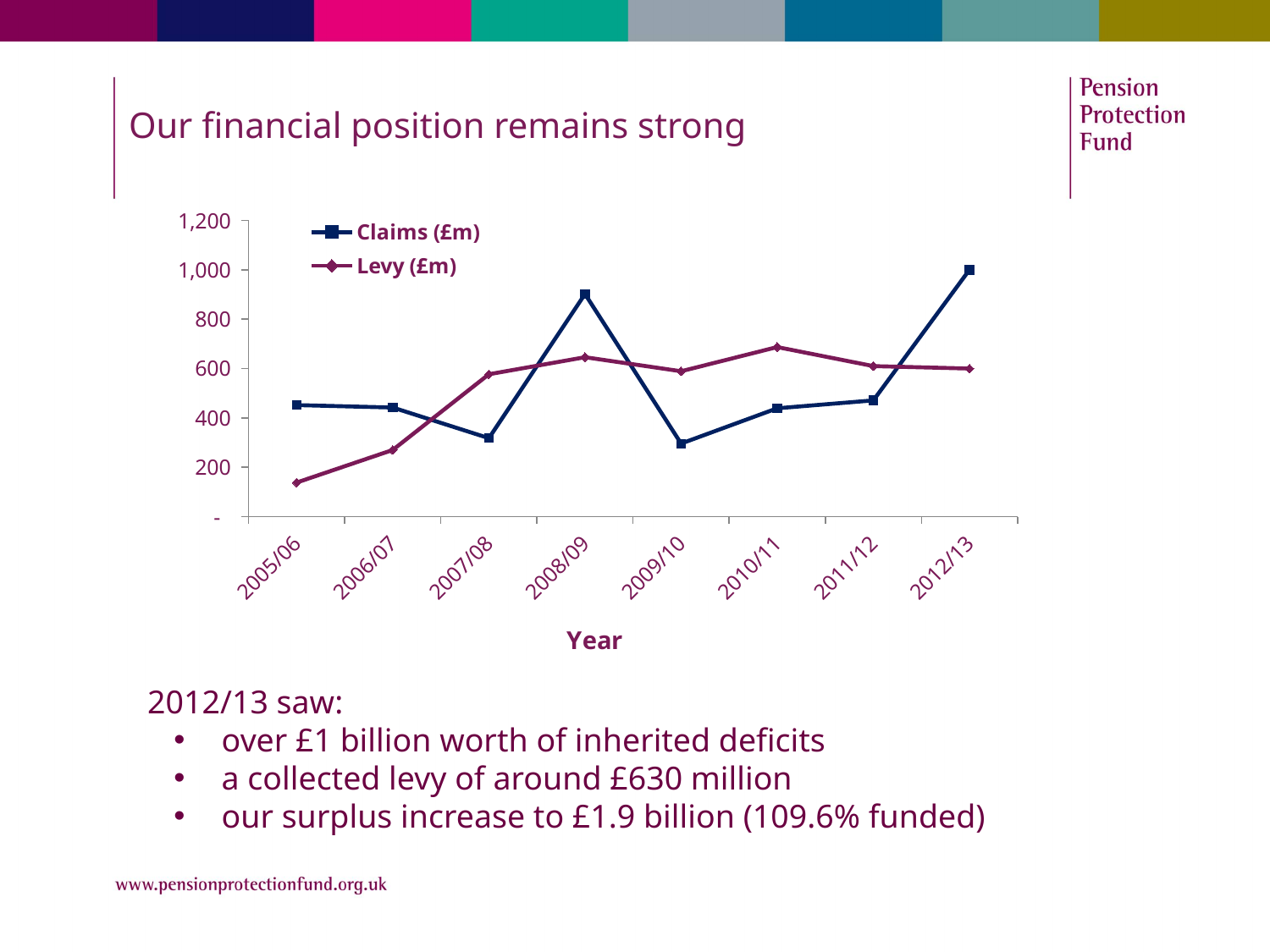
How many years are plotted along the x axis? 8 How many series does the legend list? 2 Is the value for Claims (£m) in 2008/09 greater or less than 800? greater In 2008/09, which is larger, Claims (£m) or Levy (£m)? Claims (£m) In which year is Claims (£m) highest? 2012/13 Does Levy (£m) rise or fall from 2005/06 to 2008/09? rise What is the title of the x axis? Year In which year is Levy (£m) lowest? 2005/06 In 2010/11, which is larger, Claims (£m) or Levy (£m)? Levy (£m) What kind of chart is shown on the slide? line chart In which year is Levy (£m) highest? 2010/11 Is the value for Levy (£m) in 2005/06 greater or less than 200? less